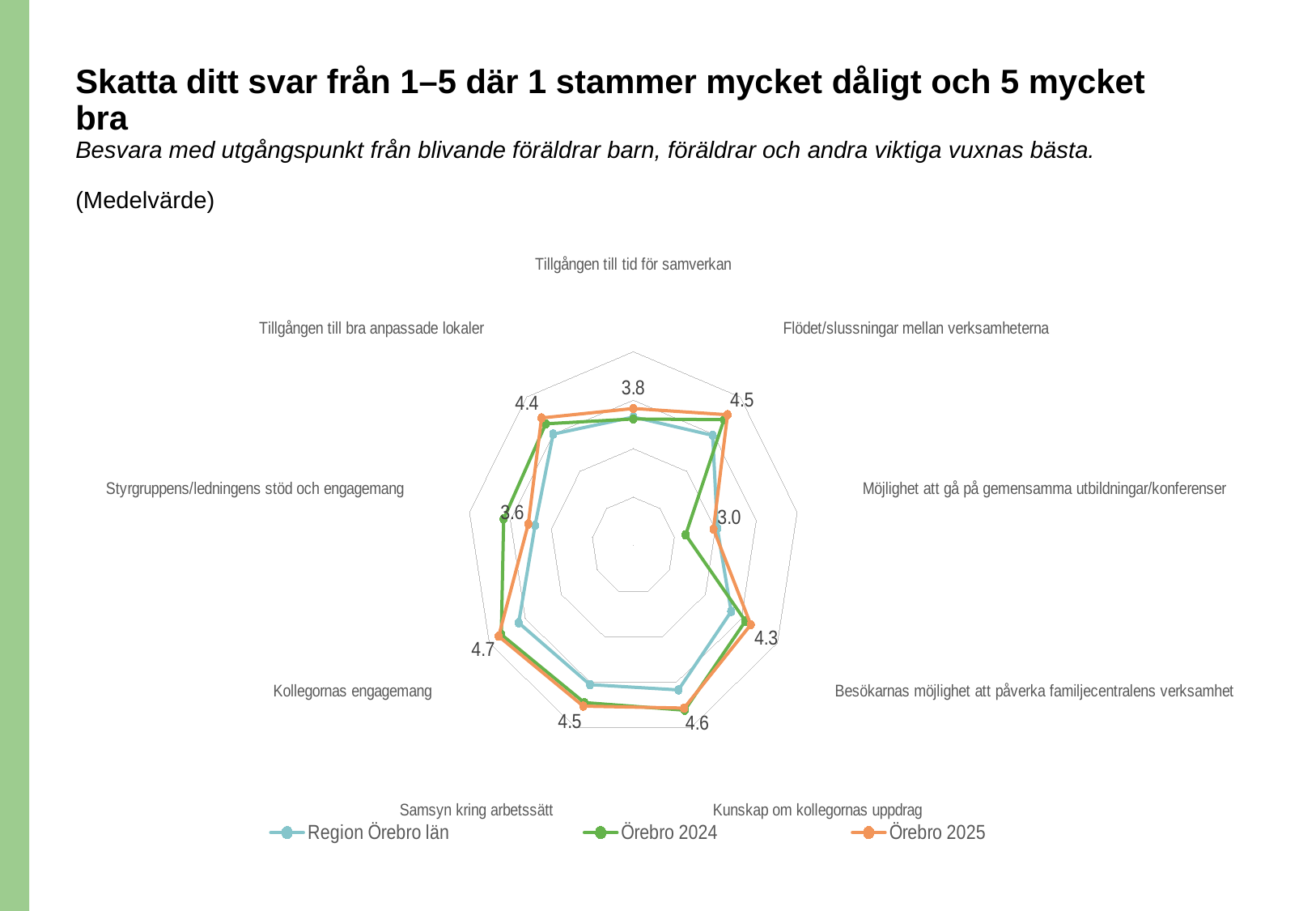
How many series does the legend list? 3 How many categories (axes) does the radar chart have? 9 Which series is shown in orange in the legend? Örebro 2025 What is the labelled value for Örebro 2025 on 'Möjlighet att gå på gemensamma utbildningar/konferenser'? 3.0 What is the labelled value for Örebro 2025 on 'Kollegornas engagemang'? 4.7 On 'Möjlighet att gå på gemensamma utbildningar/konferenser', which series is lower: Örebro 2024 or Örebro 2025? Örebro 2024 Which category has the highest labelled value for Örebro 2025? Kollegornas engagemang What is the difference between the Örebro 2025 values for 'Kollegornas engagemang' (4.7) and 'Möjlighet att gå på gemensamma utbildningar/konferenser' (3.0)? 1.7 What is the labelled value for Örebro 2025 on 'Tillgången till tid för samverkan'? 3.8 What kind of chart is shown on the slide? Radar chart Which category has the lowest labelled value for Örebro 2025? Möjlighet att gå på gemensamma utbildningar/konferenser For Örebro 2025, which is larger: 'Kunskap om kollegornas uppdrag' or 'Samsyn kring arbetssätt'? Kunskap om kollegornas uppdrag